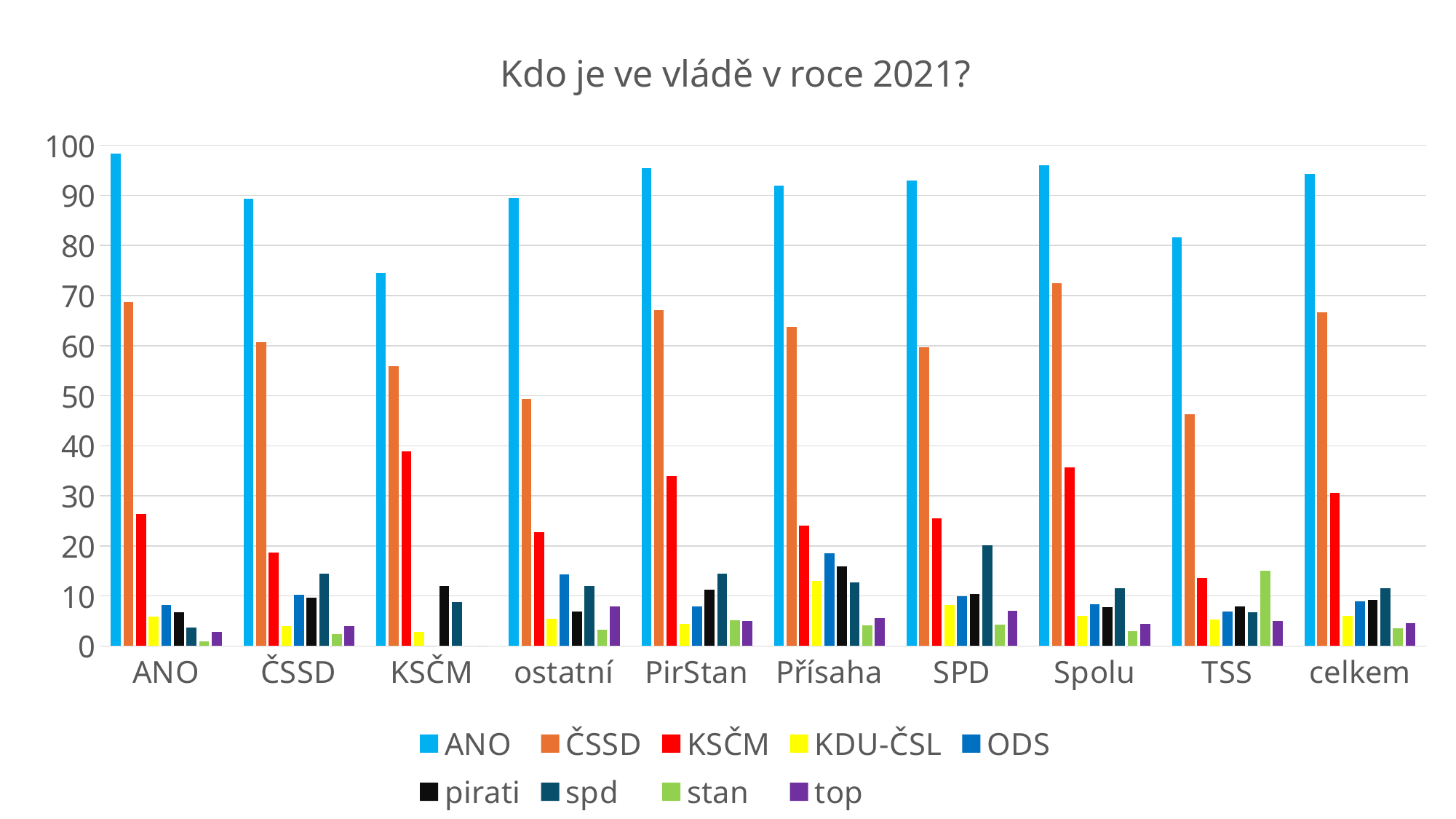
For the KSČM series, which category has the larger value: KSČM or ANO? KSČM Which category has the lowest value for the ČSSD series? TSS How many categories are shown on the x axis? 10 Which category has the lowest value for the ANO series? KSČM For the ODS series, which category has the larger value: Přísaha or ANO? Přísaha What is the title of the chart? Kdo je ve vládě v roce 2021? How many series does the legend list? 9 Is the ČSSD series value for the TSS category greater or less than 50? less Is the ANO series value for the KSČM category greater or less than 80? less Is the ANO series value for the ANO category greater or less than 90? greater What kind of chart is shown on the slide? bar chart